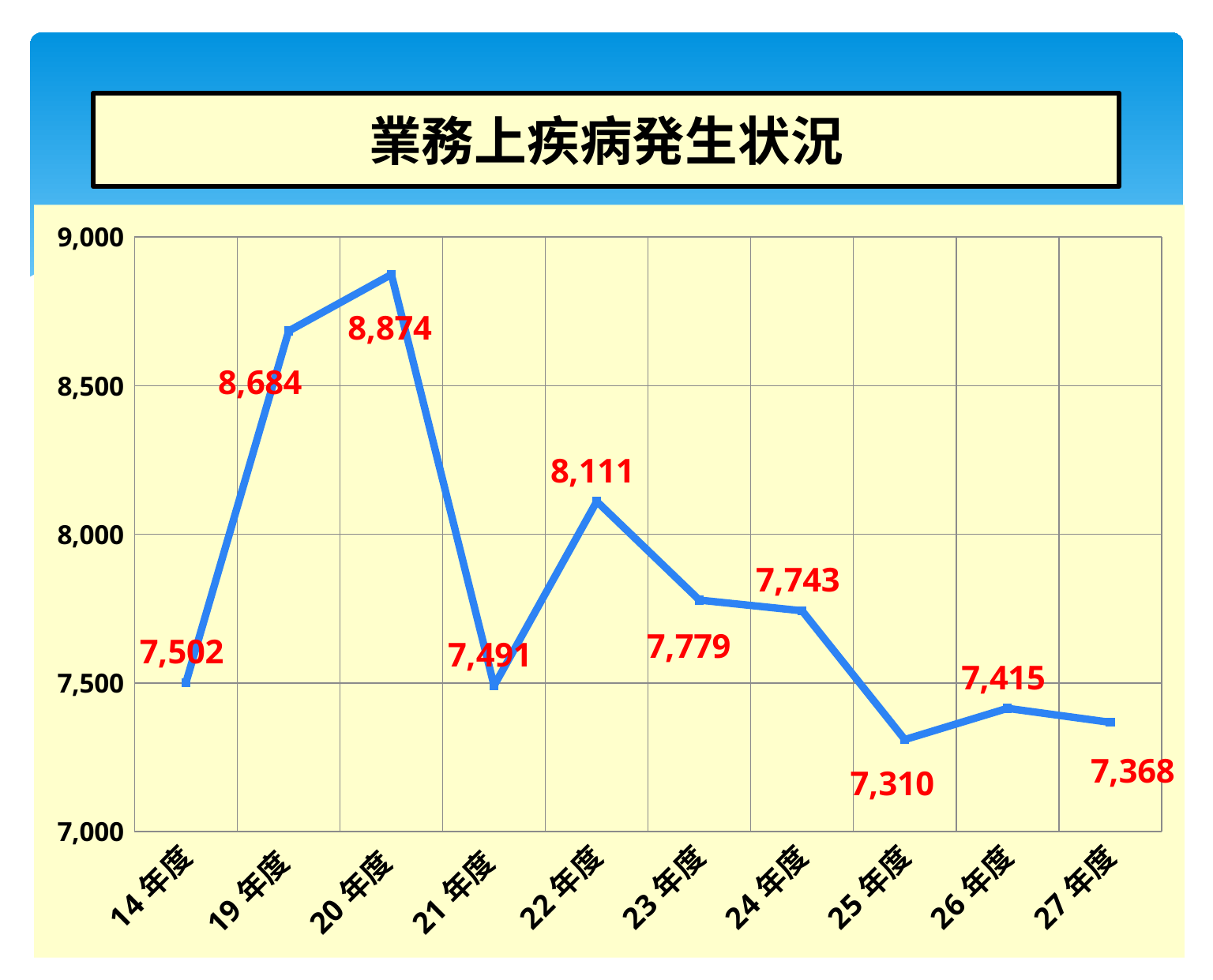
Which year has the highest value? 20年度 What is the value for 14年度? 7,502 How many years are plotted on the x axis? 10 What kind of chart is shown? line chart What is the title of the chart? 業務上疾病発生状況 What is the value for 25年度? 7,310 What is the value for 20年度? 8,874 What is the difference between the values for 20年度 and 21年度? 1,383 Is the value for 19年度 greater or less than 8,500? greater Which year has the lowest value? 25年度 What is the difference between the values for 26年度 and 27年度? 47 Which is larger, the value for 22年度 or the value for 23年度? 22年度